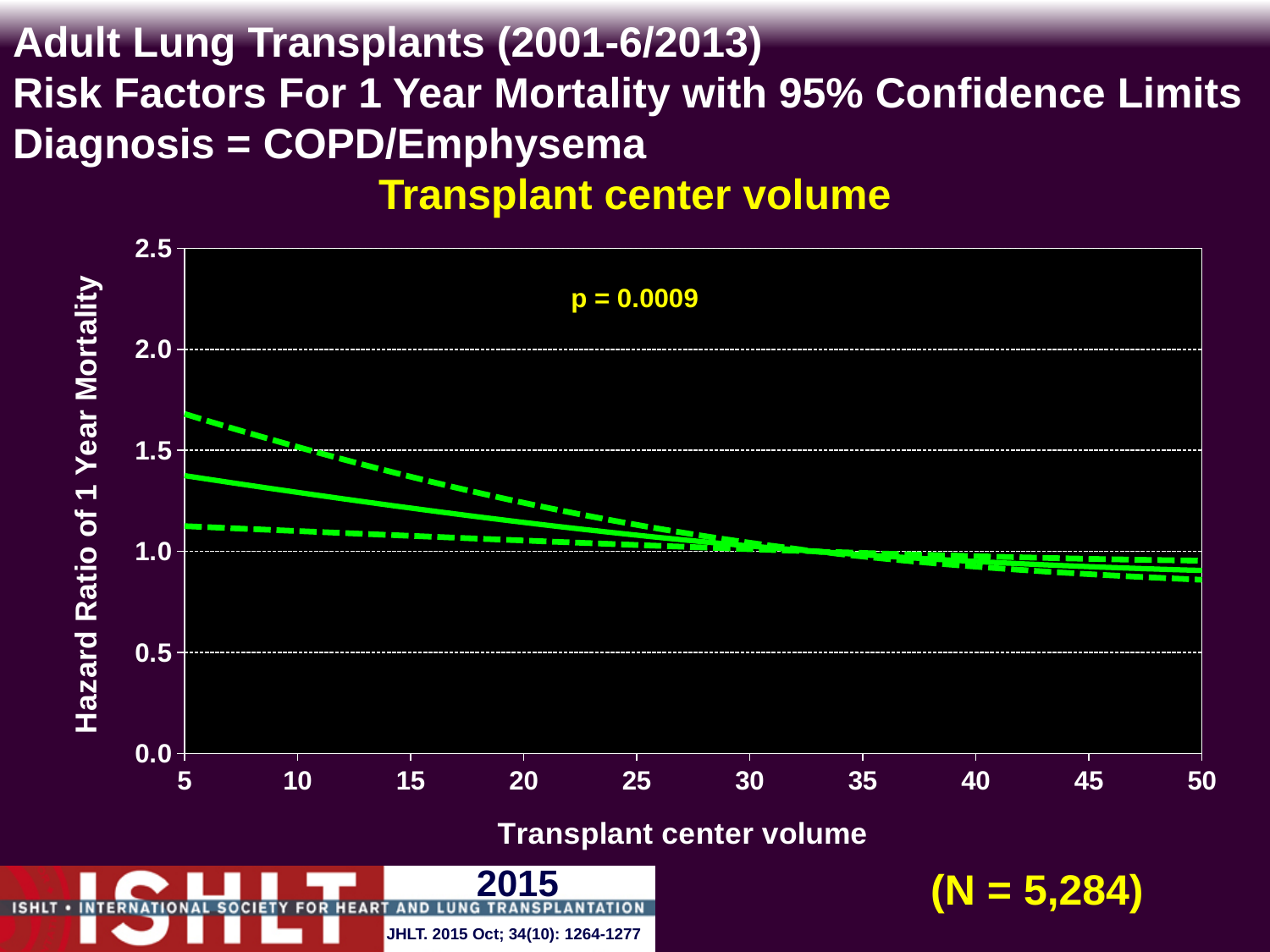
Is the upper 95% confidence limit (upper dashed line) at a transplant center volume of 5 greater or less than 1.5? greater How many lines are plotted on the chart? 3 What p-value is printed on the chart? p = 0.0009 What is the highest value shown on the y axis of the chart? 2.5 Is the lower 95% confidence limit (lower dashed line) at a transplant center volume of 5 greater or less than 1.0? greater Is the hazard ratio (solid line) at a transplant center volume of 20 greater or less than 1.0? greater What kind of chart is shown on the slide? line chart Does the hazard ratio (solid line) rise or fall as transplant center volume increases from 5 to 50? fall